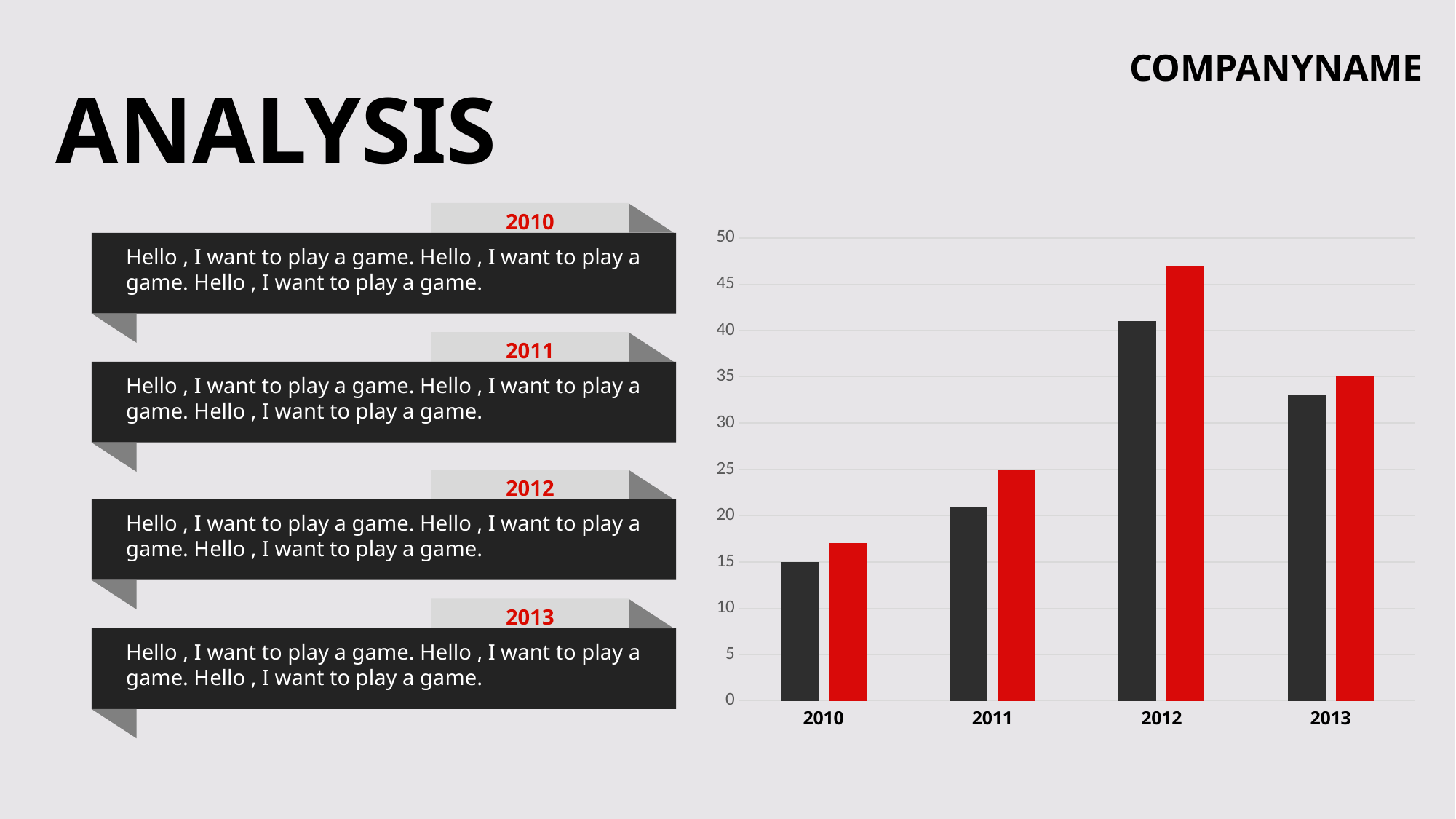
How many years are shown on the x axis of the chart? 4 How many bars are plotted for each year in the chart? 2 Is the red bar for 2012 greater or less than 45? greater Do the red bars rise or fall from 2010 to 2012? rise What kind of chart is shown on the slide? bar chart Is the dark bar for 2013 greater or less than 35? less Which year has a taller dark bar, 2012 or 2013? 2012 Which year has the shortest dark bar in the chart? 2010 Which is taller in 2011, the dark bar or the red bar? the red bar Which year has the tallest red bar in the chart? 2012 Is the red bar for 2010 greater or less than 20? less